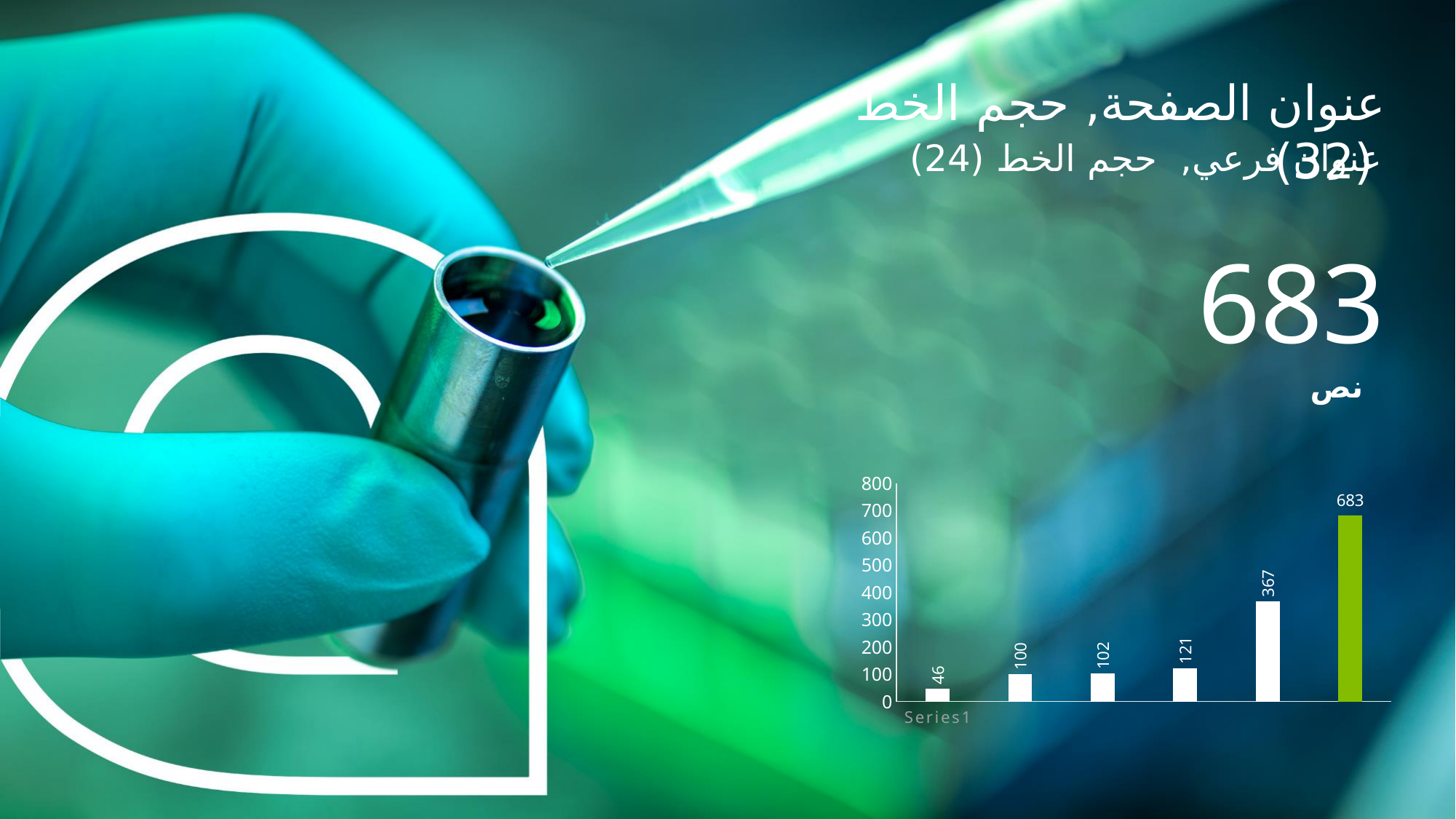
What is the value of the fifth bar from the left in the chart? 367 What is the highest value shown on the chart's vertical axis? 800 Which is larger, the second bar (100) or the third bar (102)? the third bar, 102 How many bars are plotted in the chart? 6 Which bar has the lowest value in the chart? the leftmost bar (Series1), 46 What is the value of the fourth bar from the left in the chart? 121 What is the difference between the rightmost bar (683) and the fifth bar (367)? 316 Do the bar values rise or fall from left to right across the chart? rise What kind of chart is shown on the slide? bar chart What is the value of the first (leftmost) bar, labelled Series1? 46 Which bar has the highest value in the chart? the rightmost (green) bar, 683 What is the value of the green bar (the rightmost bar) in the chart? 683